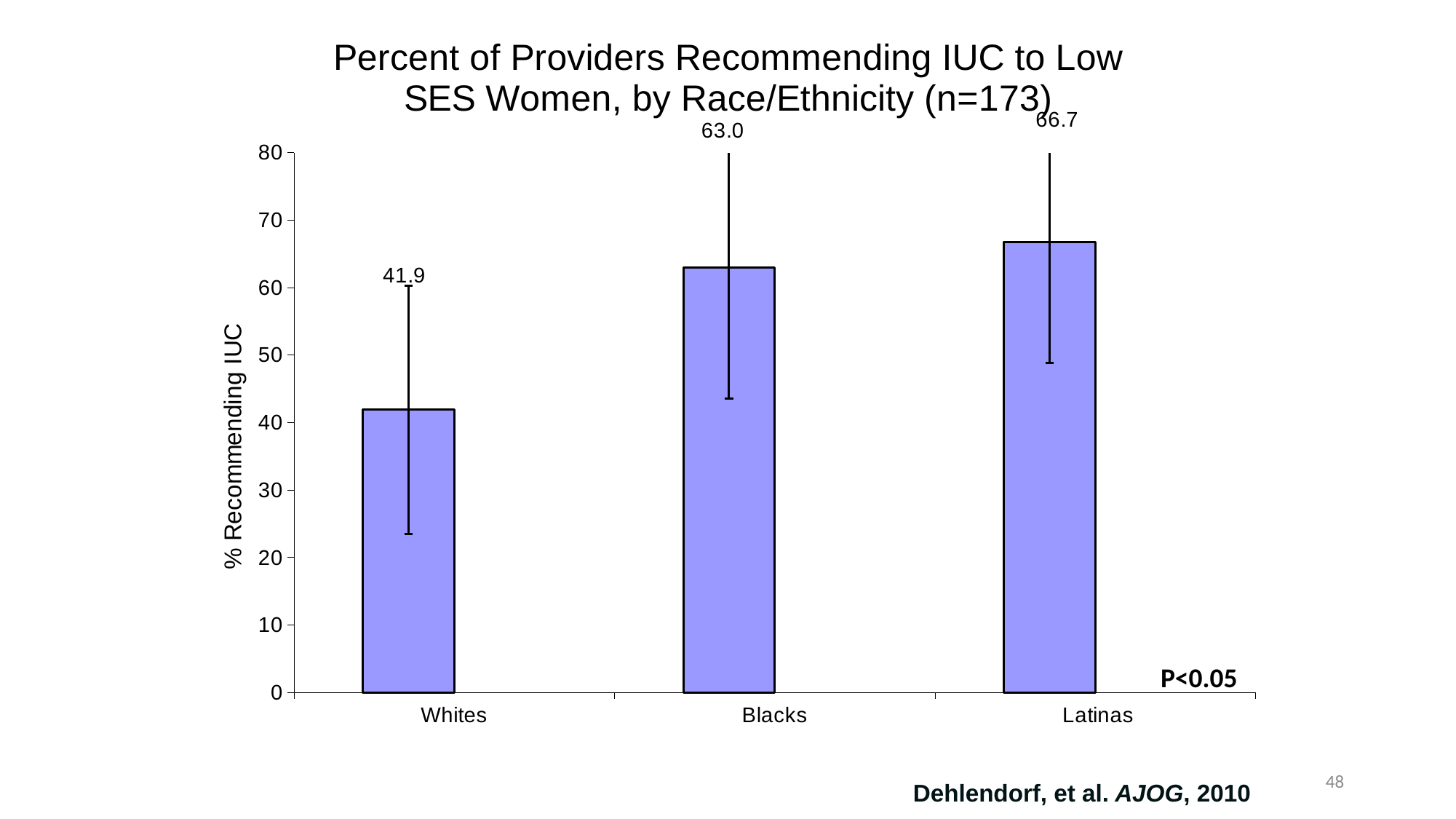
Which race/ethnicity group has the highest percent of providers recommending IUC? Latinas What is the value shown for Blacks? 63.0 What is the difference between the values for Blacks and Whites? 21.1 What is the difference between the values for Latinas and Whites? 24.8 Which is larger, the value for Blacks or the value for Whites? Blacks Is the value for Whites greater or less than 50? less What is the label of the y axis? % Recommending IUC What is the value shown for Latinas? 66.7 Which race/ethnicity group has the lowest percent of providers recommending IUC? Whites What kind of chart is shown on the slide? Bar chart How many race/ethnicity categories are shown on the chart? 3 What percent of providers recommended IUC to low SES White women? 41.9